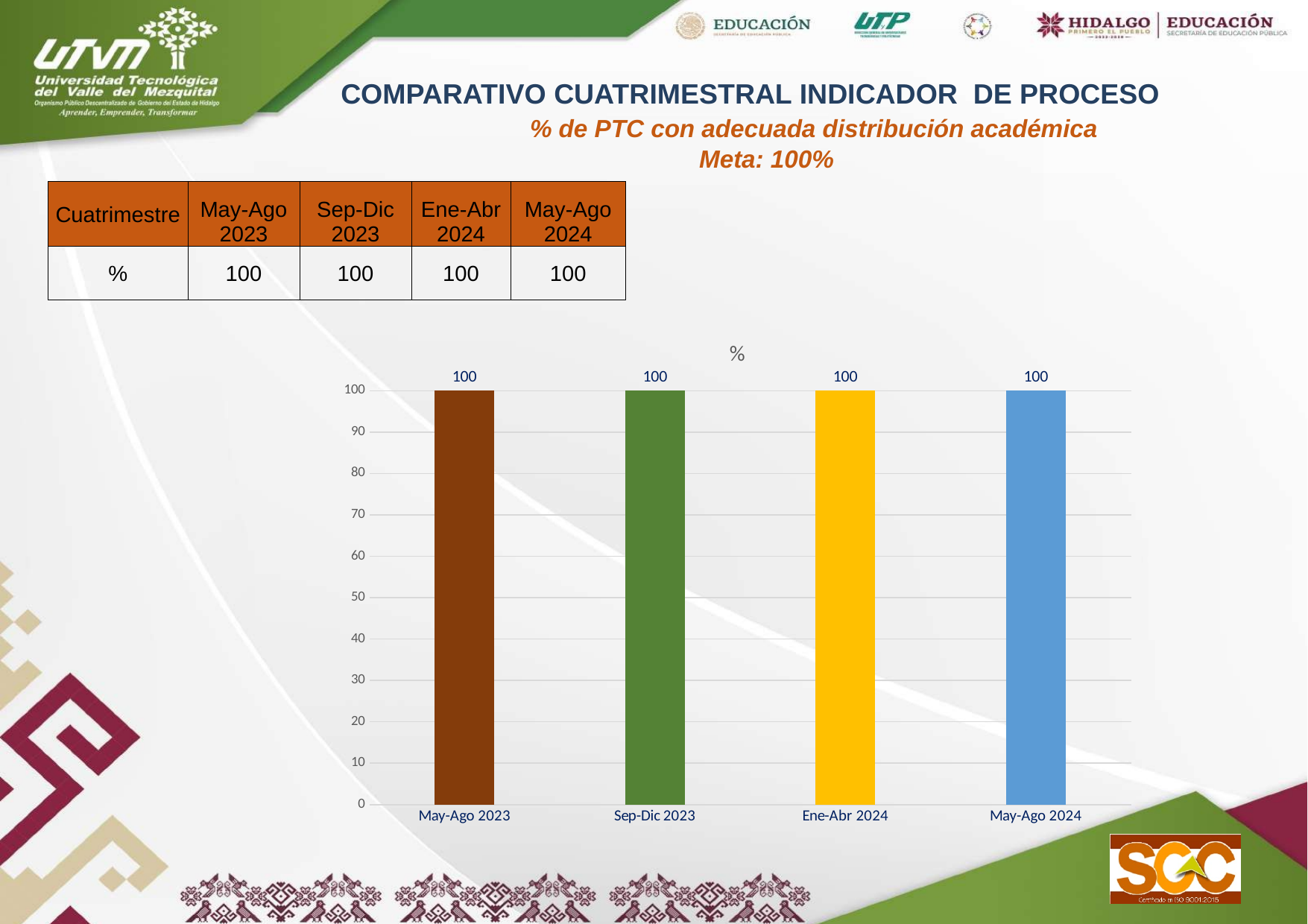
What is the value for May-Ago 2023? 100 What is the title shown above the chart? % What is the value for May-Ago 2024? 100 What is the value for Sep-Dic 2023? 100 What is the difference between the values for May-Ago 2024 and May-Ago 2023? 0 Is the value for Ene-Abr 2024 greater or less than 50? greater What is the value for Ene-Abr 2024? 100 What colour is the bar for Sep-Dic 2023? green Do the values rise, fall or stay the same from May-Ago 2023 to May-Ago 2024? stay the same What kind of chart is shown on the slide? bar chart How many categories are shown on the x axis of the chart? 4